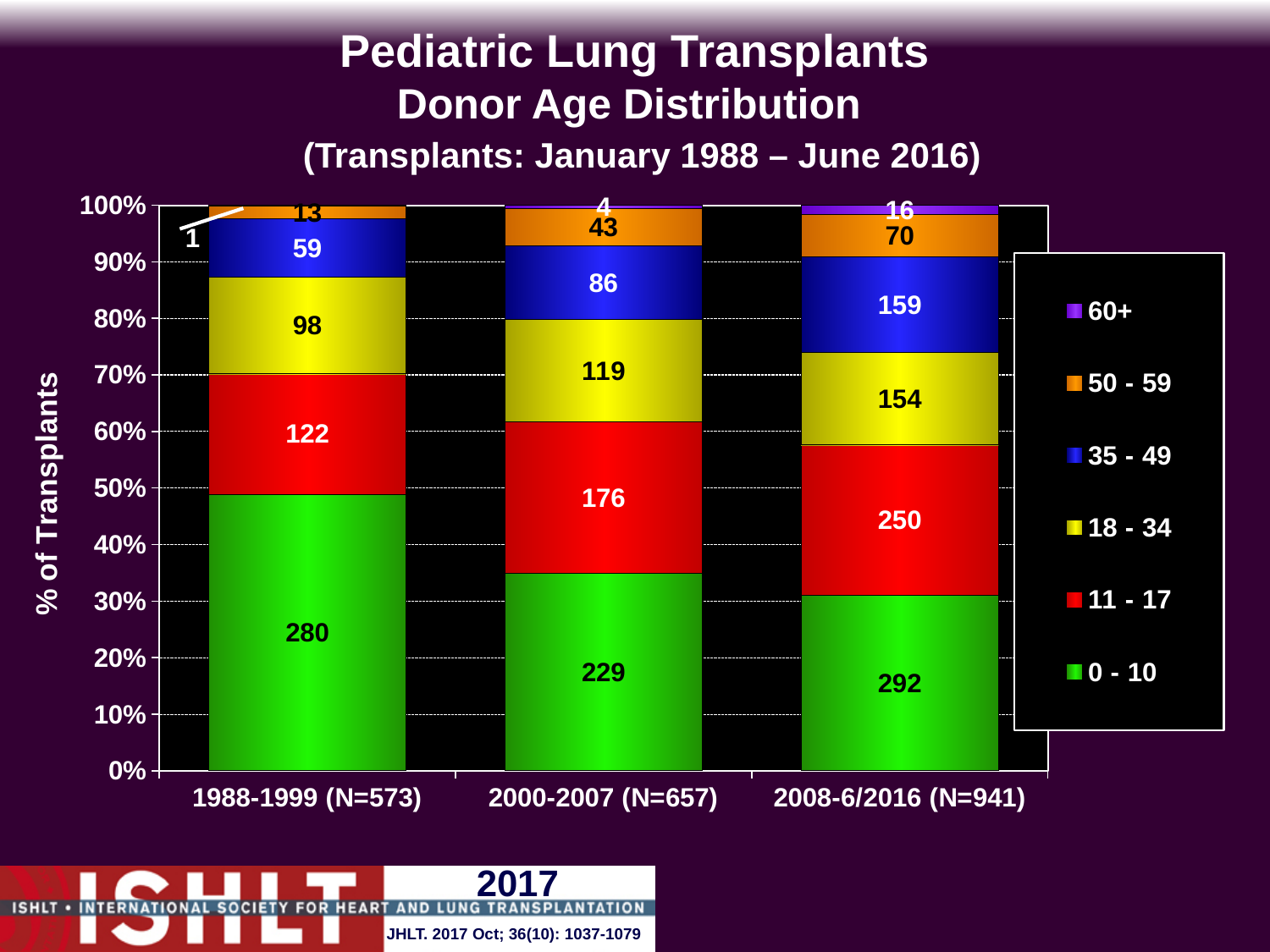
What is the number of transplants from donors aged 0 - 10 in the 1988-1999 period? 280 How many donor age groups does the legend list? 6 What is the number of transplants from donors aged 35 - 49 in the 2008-6/2016 period? 159 Which donor age group has the largest count in the 2008-6/2016 bar? 0 - 10 Which is larger in the 2008-6/2016 period: the 18 - 34 count or the 35 - 49 count? 35 - 49 What kind of chart is shown on the slide? stacked bar chart Is the share of the 0 - 10 segment in the 2008-6/2016 bar greater or less than 40%? less Does the count of transplants from donors aged 11 - 17 rise or fall across the three periods? rise Which donor age group has the smallest count in the 1988-1999 bar? 60+ What is the number of transplants from donors aged 50 - 59 in the 2000-2007 period? 43 What is the difference between the 11 - 17 counts for 2008-6/2016 and 2000-2007? 74 How many time periods are shown on the x axis? 3